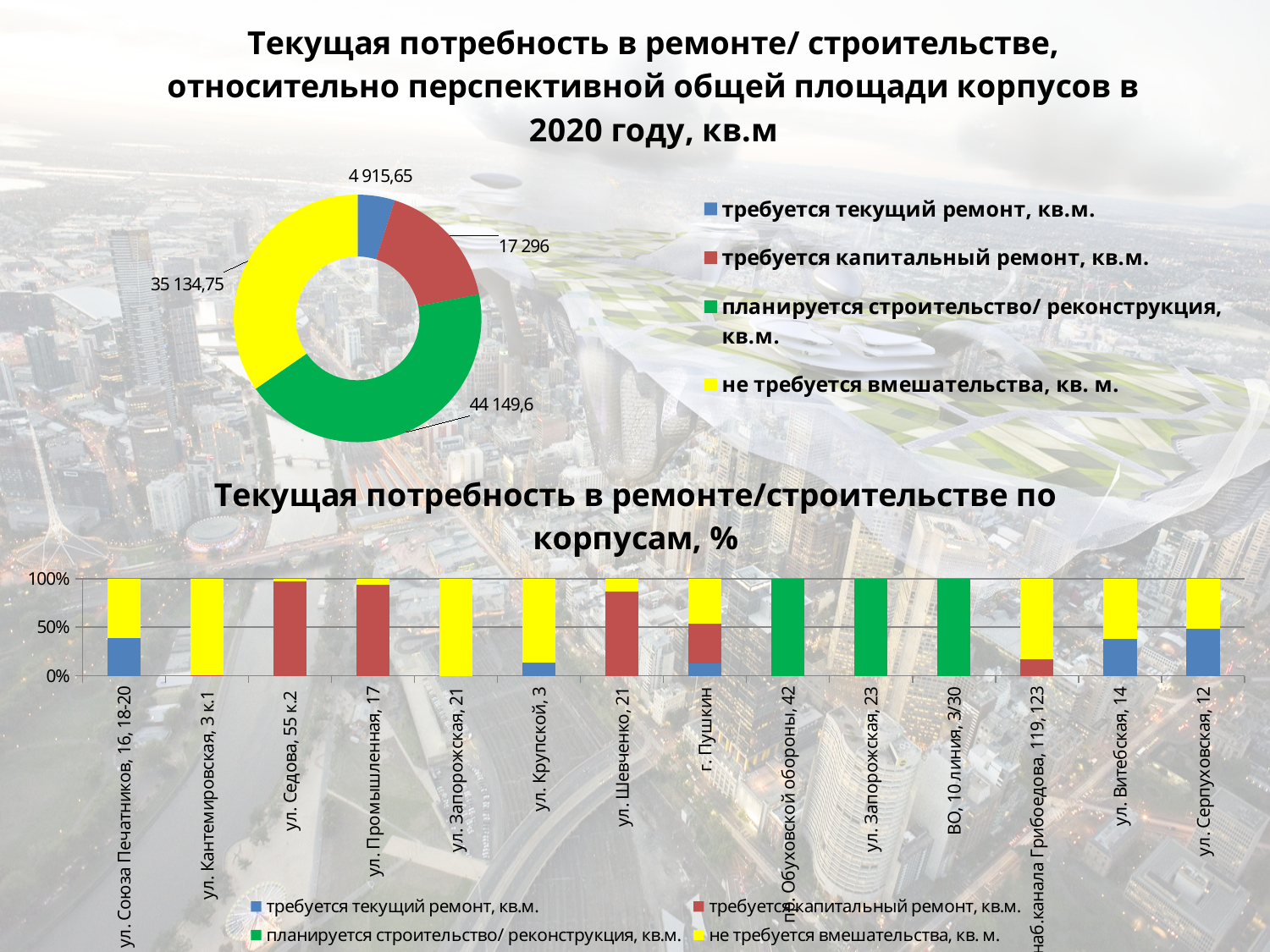
In the doughnut chart at the top of the slide, what value is shown for 'требуется текущий ремонт, кв.м.'? 4 915,65 In the doughnut chart at the top of the slide, what is the difference between the value for 'планируется строительство/ реконструкция' and the value for 'не требуется вмешательства'? 9 014,85 In the doughnut chart at the top of the slide, what value is shown for 'требуется капитальный ремонт, кв.м.'? 17 296 What type of chart is the chart titled 'Текущая потребность в ремонте/строительстве по корпусам, %'? Stacked bar chart In the doughnut chart at the top of the slide, what value is shown for 'планируется строительство/ реконструкция, кв.м.'? 44 149,6 How many buildings (categories) are shown on the x axis of the chart titled 'Текущая потребность в ремонте/строительстве по корпусам, %'? 14 In the chart titled 'Текущая потребность в ремонте/строительстве по корпусам, %', is the share of 'требуется текущий ремонт' for 'ул. Союза Печатников, 16, 18-20' greater or less than 50%? less In the doughnut chart at the top of the slide, which category has the largest value? планируется строительство/ реконструкция, кв.м. In the doughnut chart at the top of the slide, which category has the smallest value? требуется текущий ремонт, кв.м. In the doughnut chart at the top of the slide, which is larger: the value for 'требуется капитальный ремонт' or the value for 'не требуется вмешательства'? не требуется вмешательства, кв. м. How many entries does the legend of the doughnut chart at the top of the slide list? 4 In the chart titled 'Текущая потребность в ремонте/строительстве по корпусам, %', is the share of 'требуется капитальный ремонт' for 'ул. Седова, 55 к.2' greater or less than 50%? greater